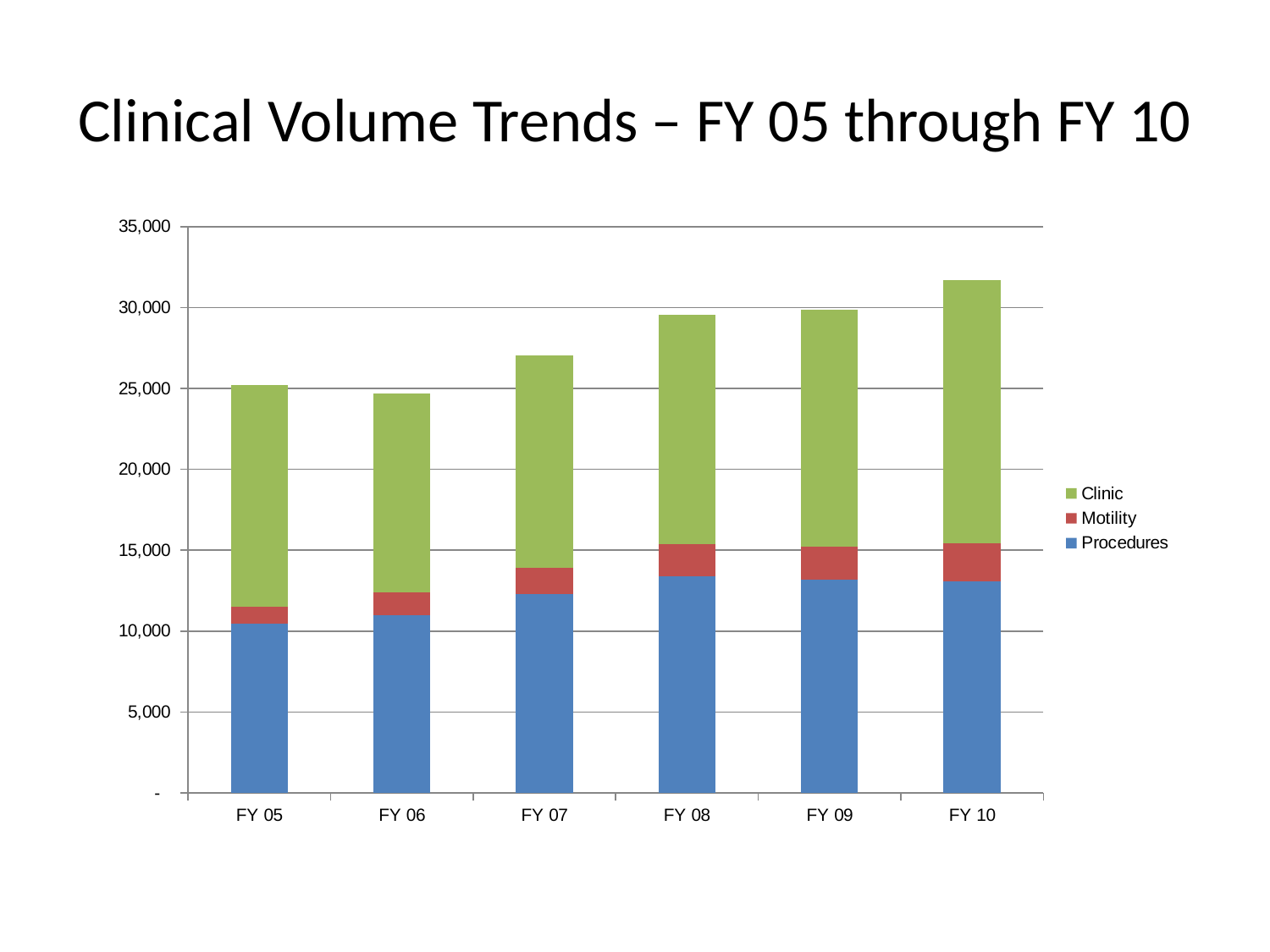
What is the title of the slide? Clinical Volume Trends – FY 05 through FY 10 Which fiscal year has the lowest total clinical volume? FY 06 How many series does the legend list? 3 Is the total bar for FY 10 greater or less than 30,000? greater How many fiscal years are shown on the x axis? 6 Do the total bars generally rise or fall from FY 06 to FY 10? rise What kind of chart is shown on the slide? Stacked bar chart Which is larger, the total bar for FY 10 or the total bar for FY 05? FY 10 Is the Procedures value for FY 08 greater or less than 15,000? less Is the total bar for FY 07 greater or less than 25,000? greater Which series is shown in green in the legend? Clinic Which fiscal year has the highest total clinical volume? FY 10